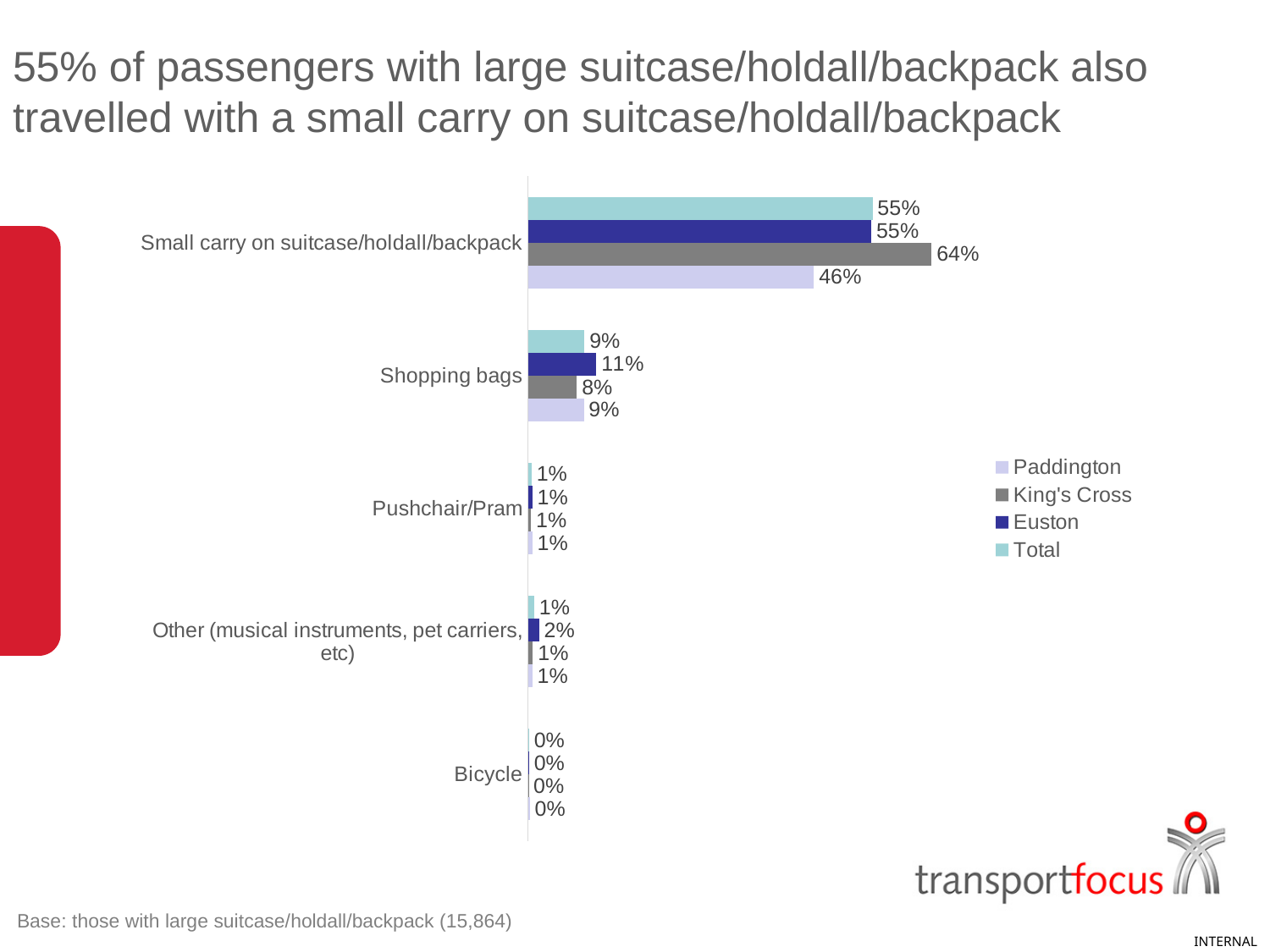
What is the difference between the King's Cross and Paddington values for Small carry on suitcase/holdall/backpack? 18% For Shopping bags, is the Euston value larger or smaller than the King's Cross value? Larger What kind of chart is shown on the slide? Bar chart What is the Euston value for Other (musical instruments, pet carriers, etc)? 2% What is the Paddington value for Small carry on suitcase/holdall/backpack? 46% What is the Euston value for Shopping bags? 11% What is the King's Cross value for Small carry on suitcase/holdall/backpack? 64% Which category has the lowest values across all series? Bicycle How many categories are shown on the chart? 5 Which station has the highest value for Small carry on suitcase/holdall/backpack? King's Cross Which station has the lowest value for Shopping bags? King's Cross How many series does the legend list? 4